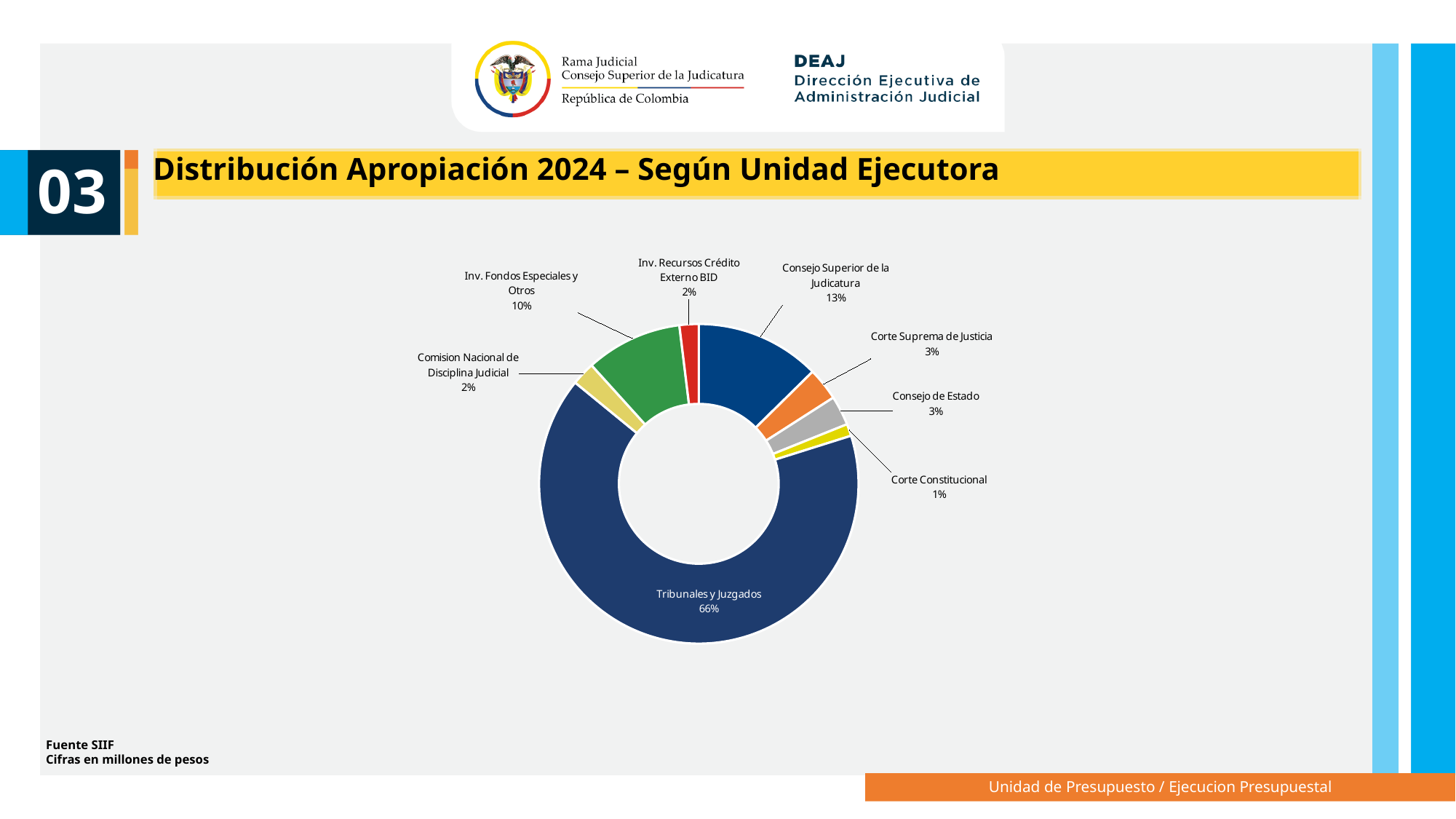
What percentage is shown for Corte Suprema de Justicia? 3% What is the title of the slide containing the chart? Distribución Apropiación 2024 – Según Unidad Ejecutora Which has a larger share, Consejo Superior de la Judicatura or Inv. Fondos Especiales y Otros? Consejo Superior de la Judicatura Which unit has the largest share of the appropriation? Tribunales y Juzgados What percentage is shown for Consejo Superior de la Judicatura? 13% How many units (slices) are shown in the chart? 8 What percentage is shown for Inv. Fondos Especiales y Otros? 10% What share of the 2024 appropriation goes to Tribunales y Juzgados? 66% What is the difference in percentage points between Consejo Superior de la Judicatura and Inv. Fondos Especiales y Otros? 3 percentage points Which unit has the smallest share of the appropriation? Corte Constitucional What type of chart is shown on the slide? Pie (donut) chart What percentage is shown for Corte Constitucional? 1%